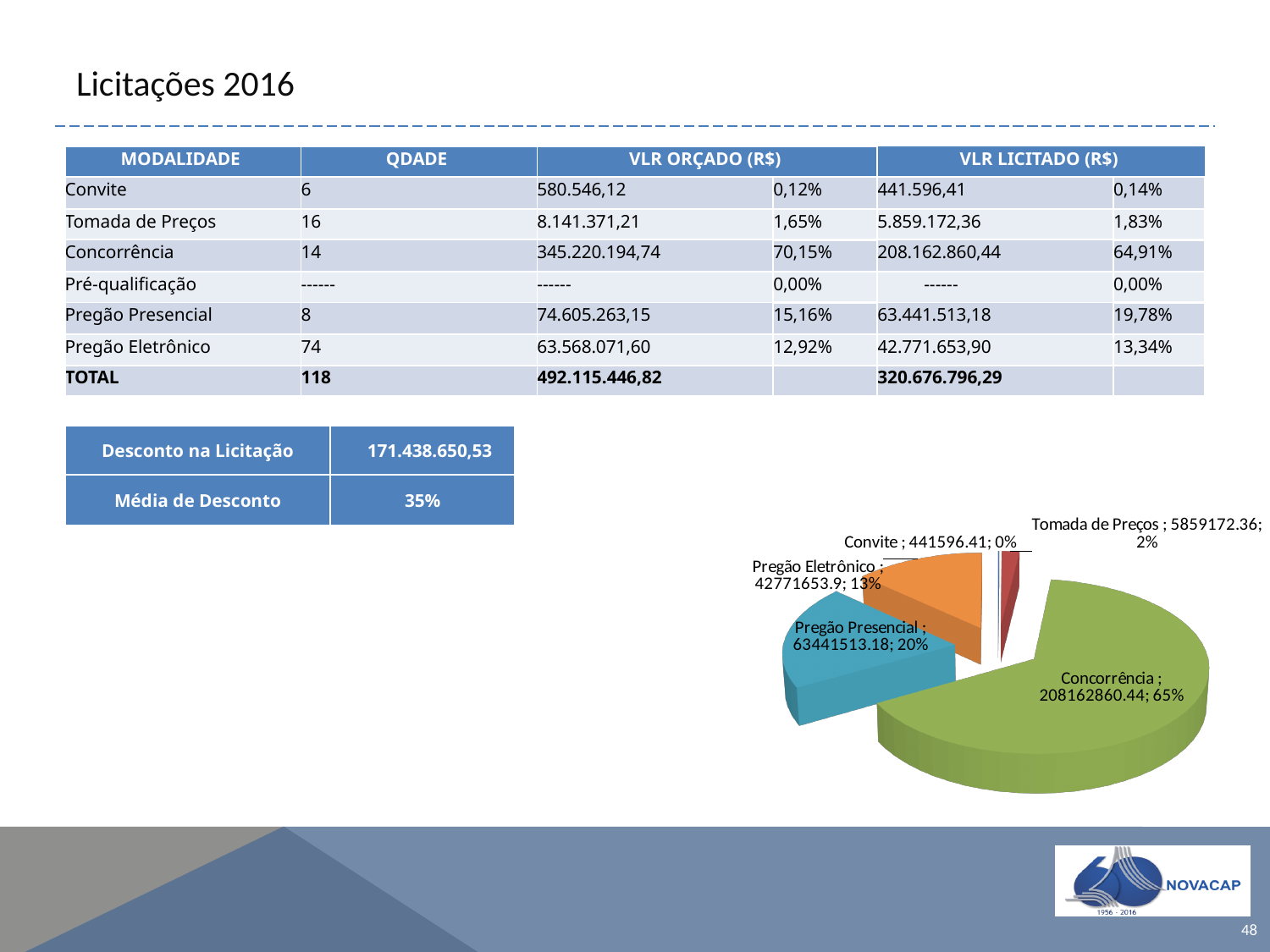
What share of the pie does Convite represent? 0% Which slice of the pie chart is the largest? Concorrência How many slices does the pie chart have? 5 What kind of chart is shown on the slide? pie chart What share of the pie does Pregão Presencial represent? 20% What value is shown for Tomada de Preços in the pie chart? 5859172.36 What value is shown for Pregão Eletrônico in the pie chart? 42771653.9 Which slice of the pie chart is the smallest? Convite What value is shown for Concorrência in the pie chart? 208162860.44 What value is shown for Pregão Presencial in the pie chart? 63441513.18 Which is larger in the pie chart, Pregão Presencial or Pregão Eletrônico? Pregão Presencial What share of the pie does Concorrência represent? 65%